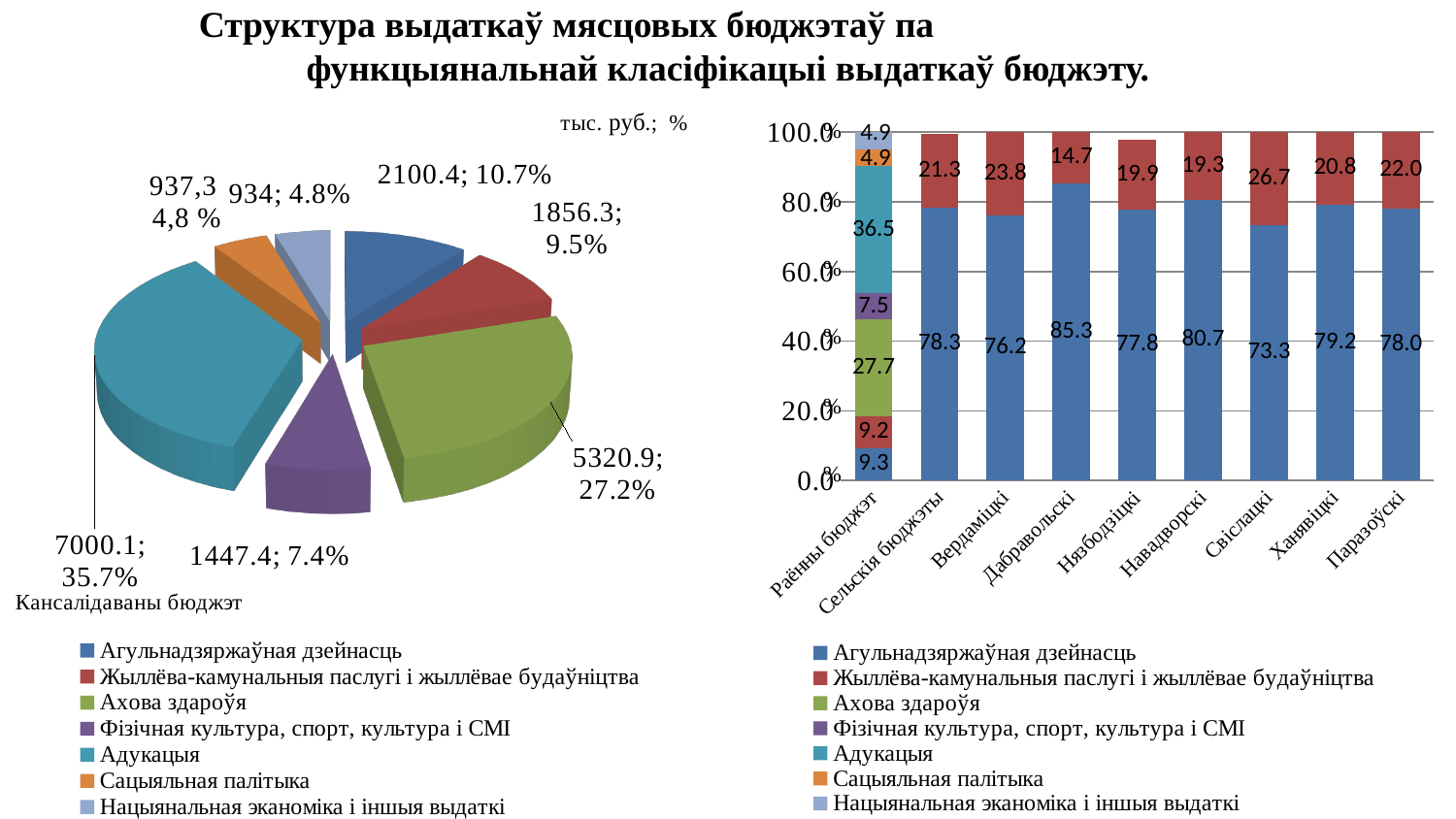
On the stacked bar chart (right), what is the value of Адукацыя for Раённы бюджэт? 36.5 On the stacked bar chart (right), what is the value of Агульнадзяржаўная дзейнасць for Дабравольскі? 85.3 What type of chart is on the right side of the slide? Stacked bar chart On the pie chart (left), what share is shown for Ахова здароўя? 27.2% On the pie chart (left), what is the difference in thousand rubles between Адукацыя (7000.1) and Ахова здароўя (5320.9)? 1679.2 On the pie chart (left), how many slices does the pie have? 7 On the pie chart (left), which category has the largest slice? Адукацыя On the pie chart (left), which is larger: Агульнадзяржаўная дзейнасць or Жыллёва-камунальныя паслугі і жыллёвае будаўніцтва? Агульнадзяржаўная дзейнасць On the stacked bar chart (right), which budget has the highest value for Агульнадзяржаўная дзейнасць? Дабравольскі On the stacked bar chart (right), which budget has the lowest value for Агульнадзяржаўная дзейнасць? Раённы бюджэт On the pie chart (left), what value and share are shown for Адукацыя? 7000.1; 35.7% On the stacked bar chart (right), how many categories are shown on the x axis? 9